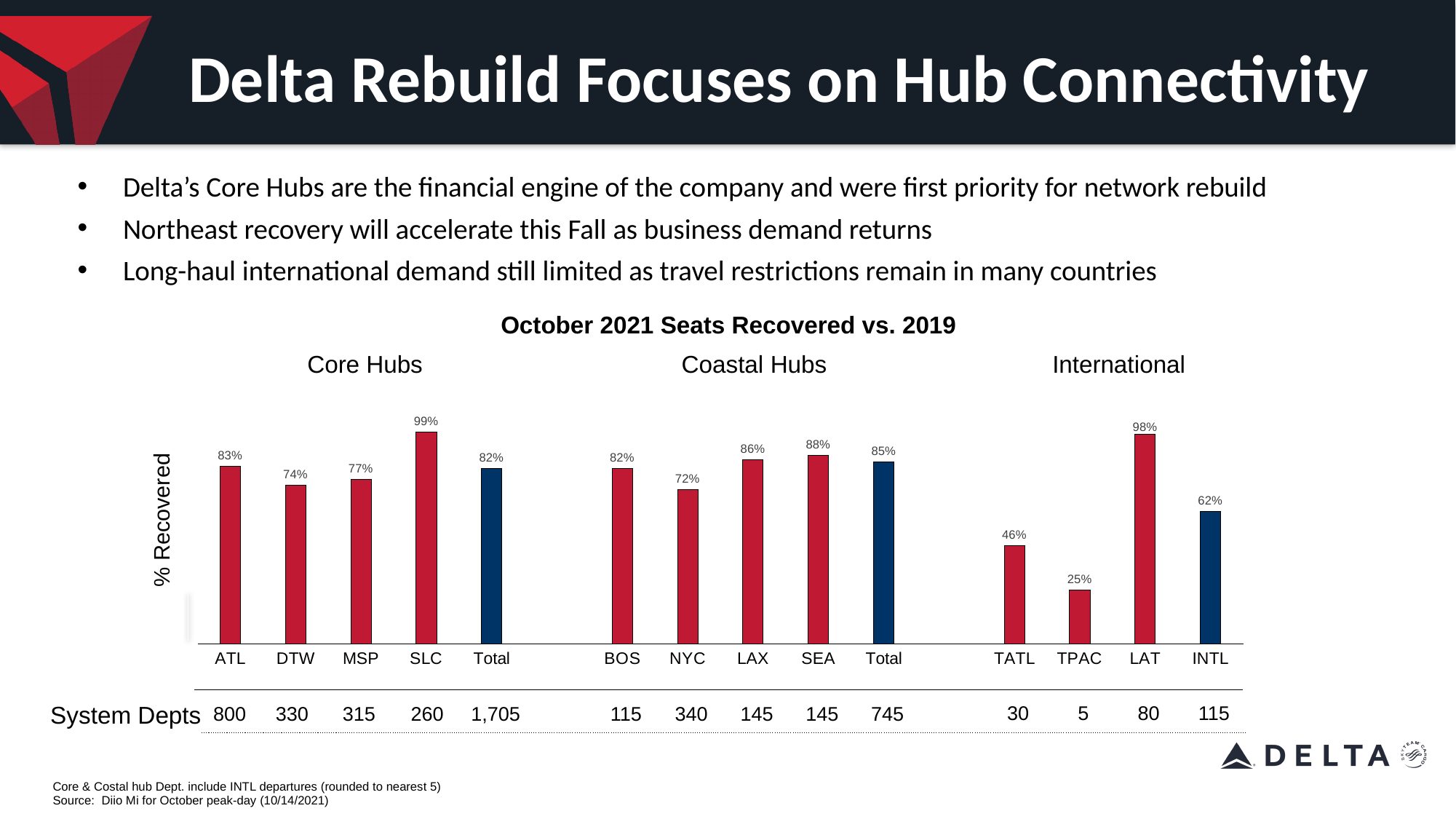
What is the percentage of seats recovered for SLC? 99% Which has a higher percentage of seats recovered, ATL or DTW? ATL How many bars are plotted in the chart in total? 14 Which Core Hub has the highest percentage of seats recovered? SLC Which category in the International group has the lowest percentage of seats recovered? TPAC What is the title of the chart? October 2021 Seats Recovered vs. 2019 What is the percentage of seats recovered for TPAC? 25% What is the percentage of seats recovered for NYC? 72% Which has a higher percentage of seats recovered, LAT or INTL? LAT What is the difference in percentage points between the seats recovered for SEA and BOS? 6 What is the percentage of seats recovered for the Coastal Hubs Total? 85% What type of chart is shown on the slide? Bar chart